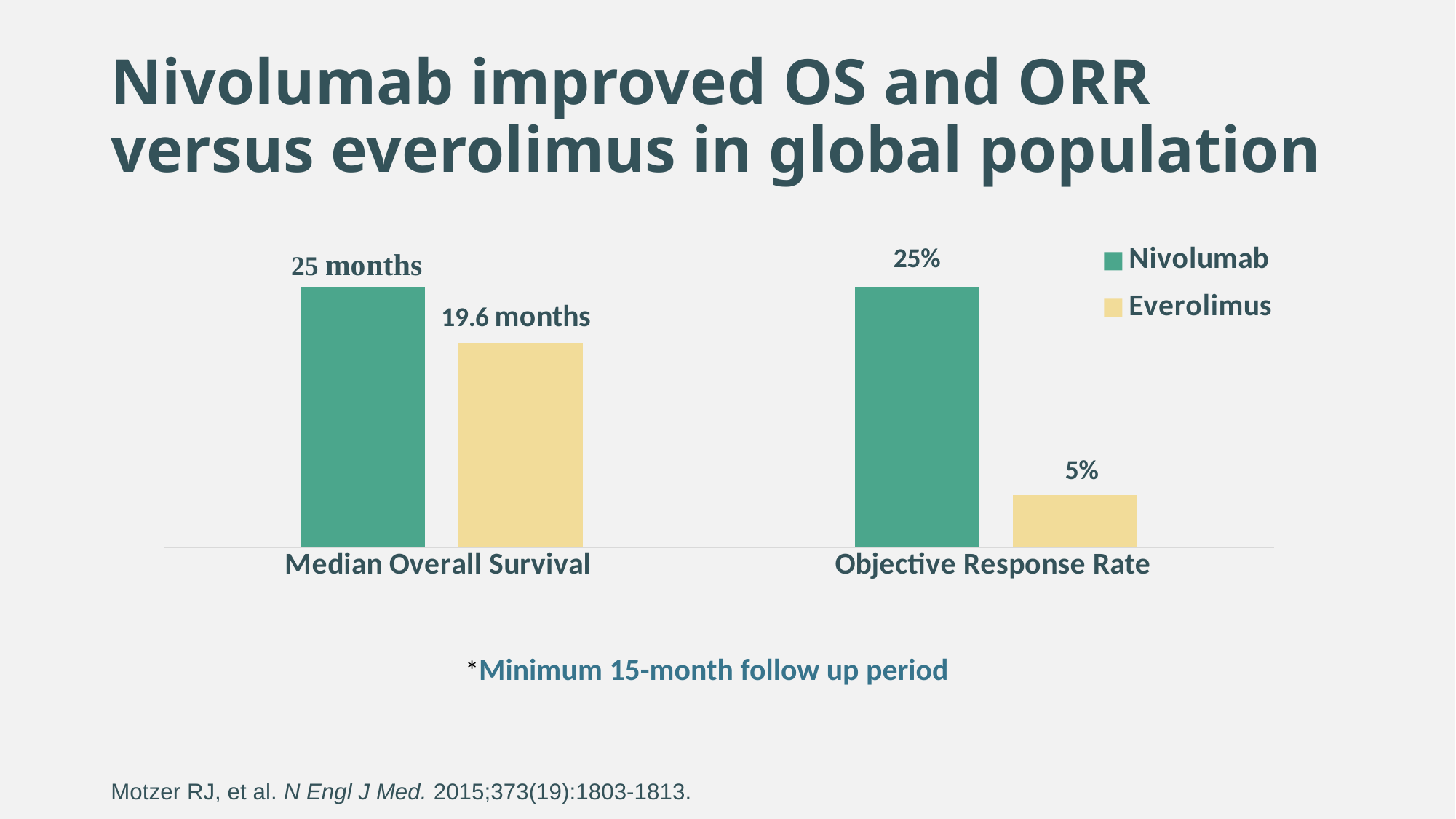
What is the Median Overall Survival for Everolimus? 19.6 months What is the difference in Objective Response Rate between Nivolumab and Everolimus? 20% How many categories are shown on the x axis? 2 How many series does the legend list? 2 Which treatment has the higher Objective Response Rate? Nivolumab What is the Objective Response Rate for Nivolumab? 25% What is the Objective Response Rate for Everolimus? 5% Which colour represents Everolimus in the chart? Yellow Which treatment has the lower Median Overall Survival? Everolimus What is the Median Overall Survival for Nivolumab? 25 months What is the difference in Median Overall Survival between Nivolumab and Everolimus? 5.4 months What kind of chart is shown on the slide? Bar chart